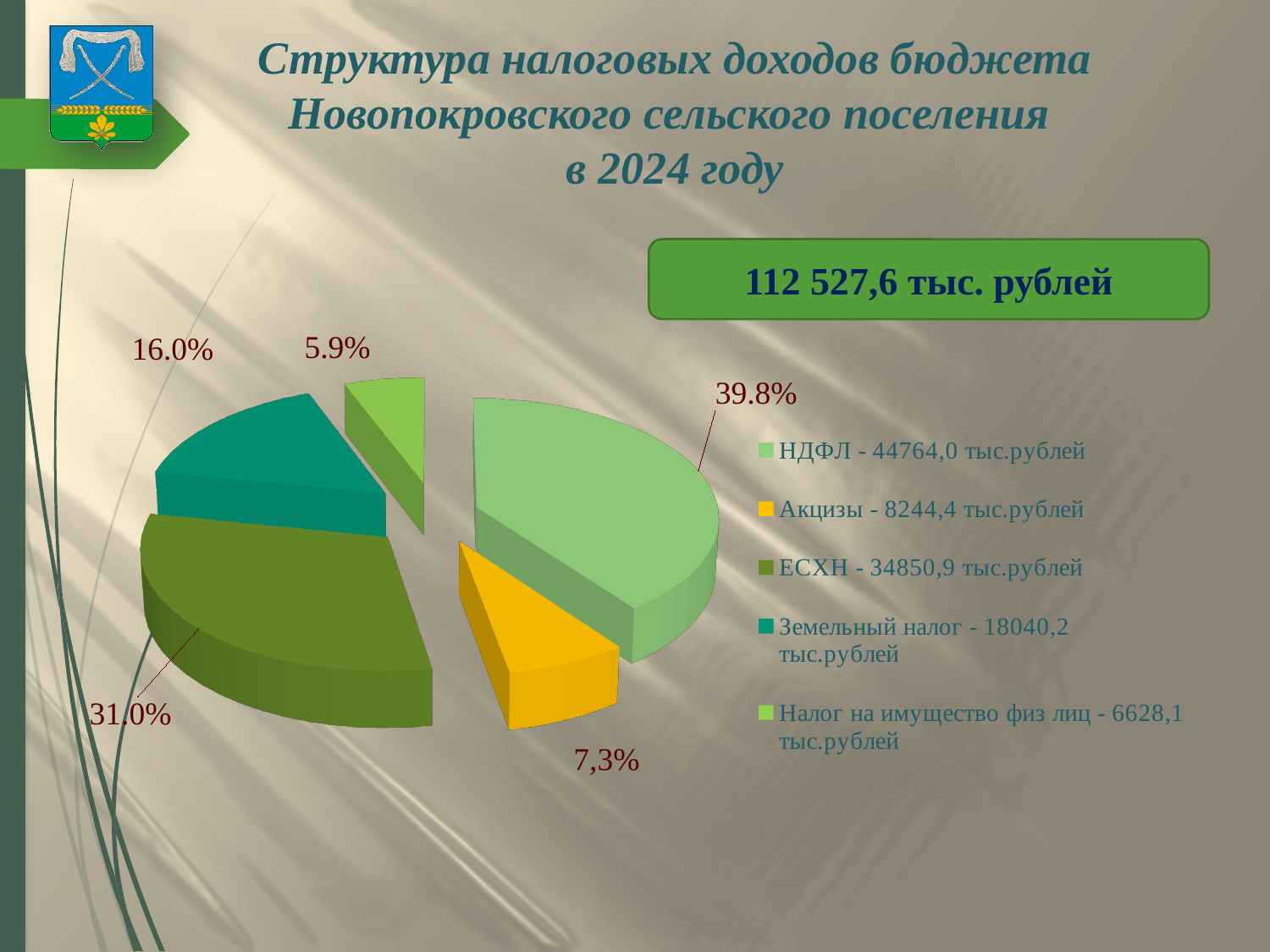
How many entries does the legend list? 5 What share of the pie does Земельный налог account for? 16.0% What share of the pie does ЕСХН account for? 31.0% What share of the pie does НДФЛ account for? 39.8% What amount in тыс.рублей does the legend give for Земельный налог? 18040,2 тыс.рублей How many slices does the pie chart have? 5 What percentage label is shown for the Акцизы slice? 7,3% Which is larger, the share for ЕСХН or the share for Земельный налог? ЕСХН What is the difference in percentage points between the НДФЛ share and the ЕСХН share? 8.8 Which category has the smallest slice of the pie? Налог на имущество физ лиц What kind of chart is shown on the slide? pie chart Which category has the largest slice of the pie? НДФЛ